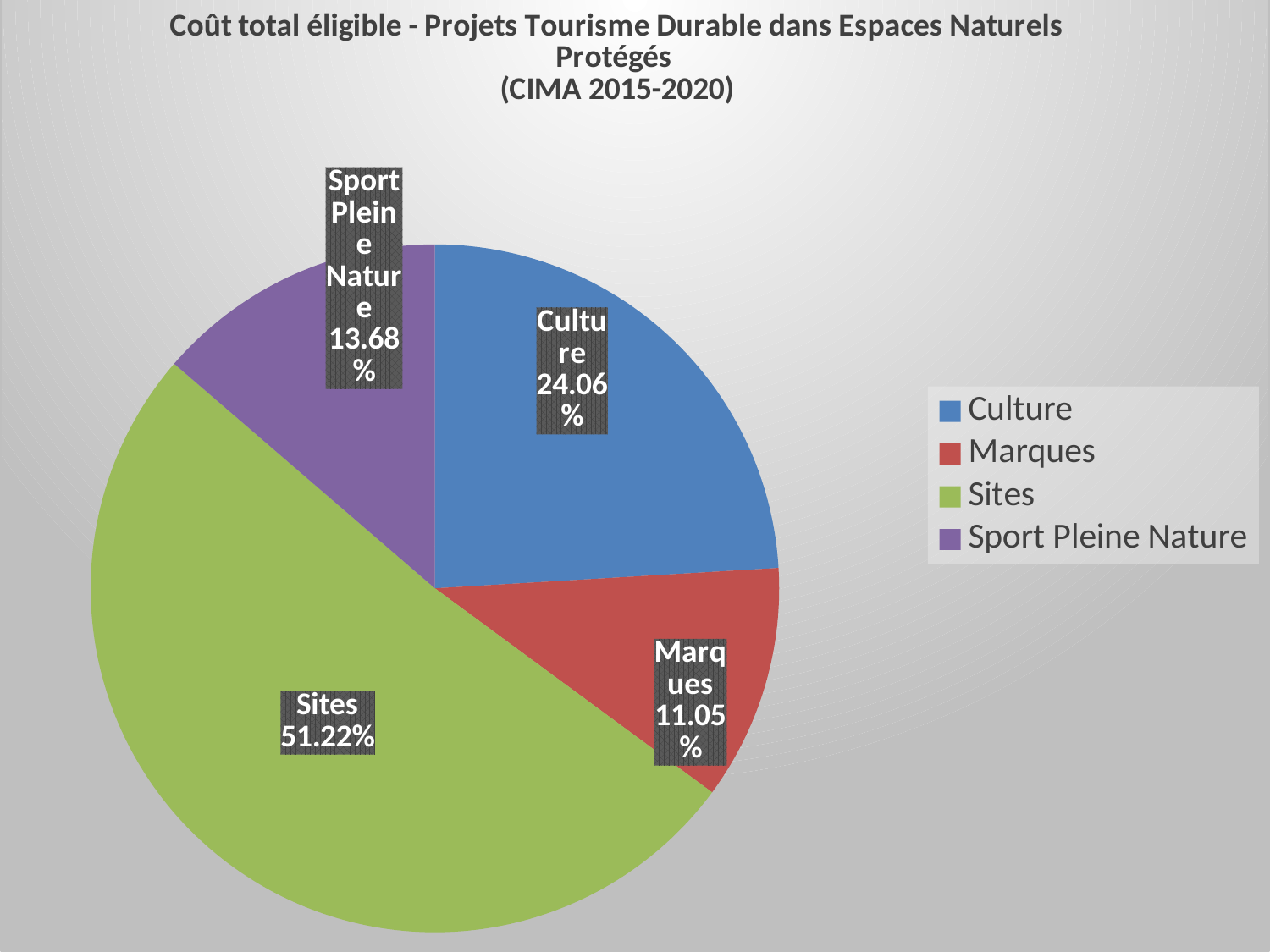
What is the difference in percentage points between the Sport Pleine Nature share and the Marques share? 2.63 Which colour represents Sites in the pie chart? Green Which category has the smallest share of the pie? Marques What is the difference in percentage points between the Sites share and the Culture share? 27.16 Which category has the largest share of the pie? Sites What share of the pie does Culture represent? 24.06% How many categories are shown in the pie chart? 4 Which is larger, the share for Culture or the share for Sport Pleine Nature? Culture What share of the pie does Sport Pleine Nature represent? 13.68% What kind of chart is shown on the slide? Pie chart What share of the pie does Sites represent? 51.22%